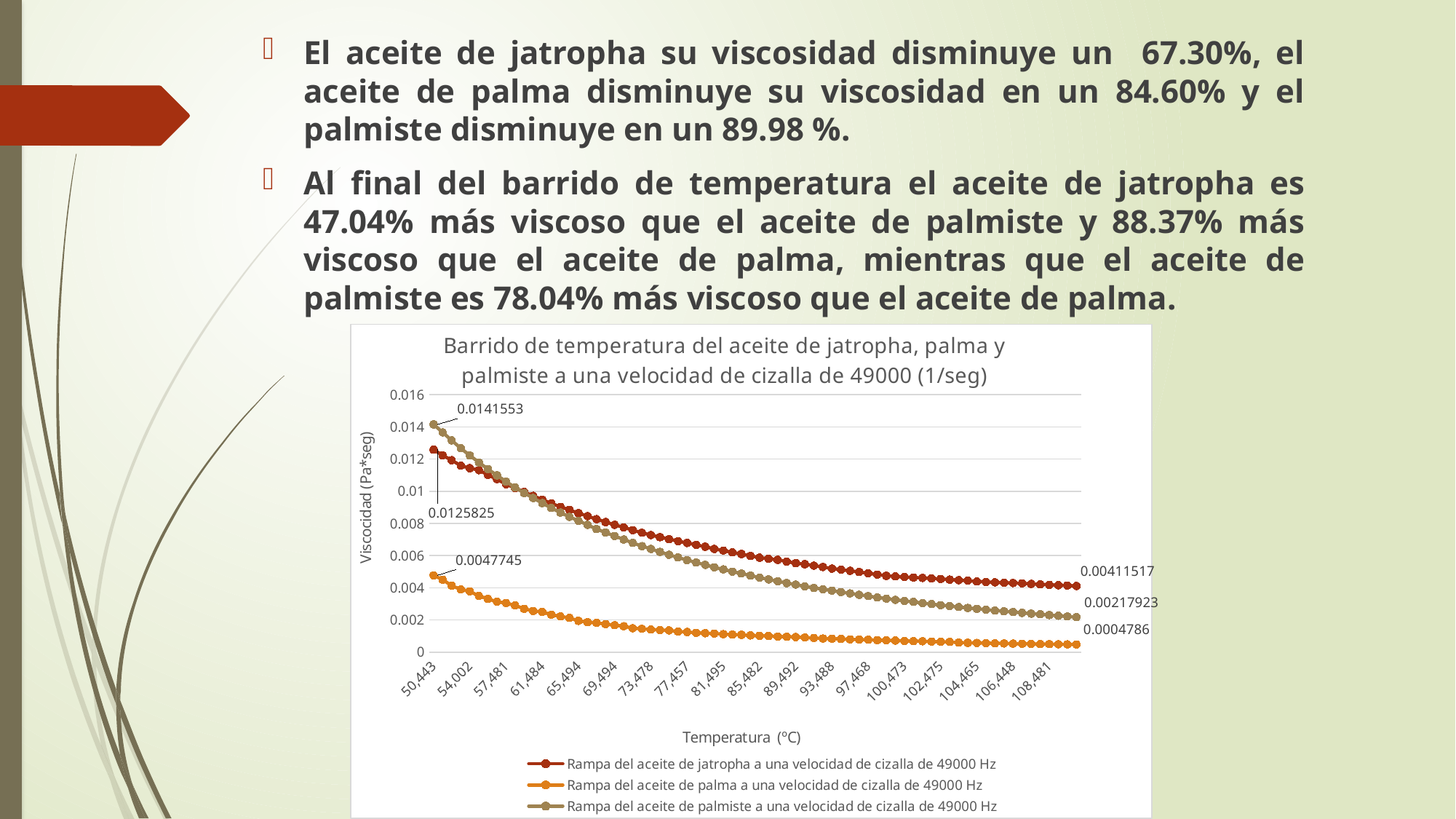
Which series has the highest starting viscosity value? Rampa del aceite de palmiste a una velocidad de cizalla de 49000 Hz What is the starting viscosity value labelled for the palma oil series? 0.0047745 What type of chart is shown on the slide? line chart Is the final viscosity value of the palmiste oil series greater or less than 0.004? less What is the label of the y axis? Viscocidad (Pa*seg) Do the viscosity values rise or fall as temperature increases along the x axis? fall What is the final viscosity value labelled for the jatropha oil series? 0.00411517 What is the starting viscosity value labelled for the jatropha oil series? 0.0125825 How many series does the legend list? 3 What is the final viscosity value labelled for the palma oil series? 0.0004786 What is the starting viscosity value labelled for the palmiste oil series? 0.0141553 Which series has the lowest viscosity at the end of the temperature sweep? Rampa del aceite de palma a una velocidad de cizalla de 49000 Hz